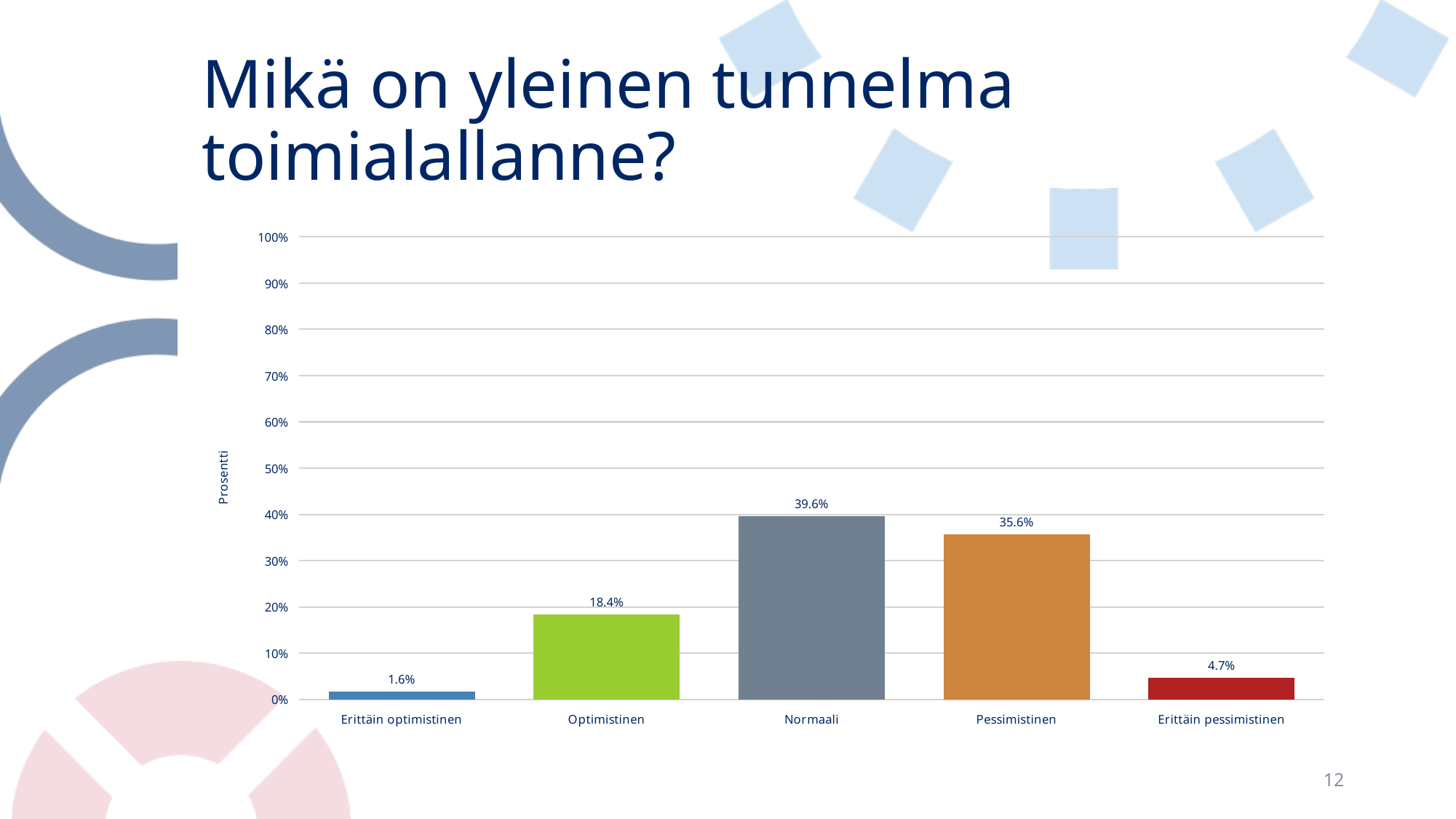
Which category has the highest value? Normaali What is the value for Erittäin optimistinen? 1.6% What is the value for Normaali? 39.6% What is the value for Erittäin pessimistinen? 4.7% Is the value for Pessimistinen greater or less than 30%? greater Which is larger, the value for Optimistinen or the value for Pessimistinen? Pessimistinen What is the label of the vertical axis? Prosentti How many categories are shown on the x axis? 5 Which category has the lowest value? Erittäin optimistinen What kind of chart is shown on the slide? bar chart What is the difference between the values for Optimistinen and Erittäin pessimistinen? 13.7% What is the difference between the values for Normaali and Pessimistinen? 4.0%